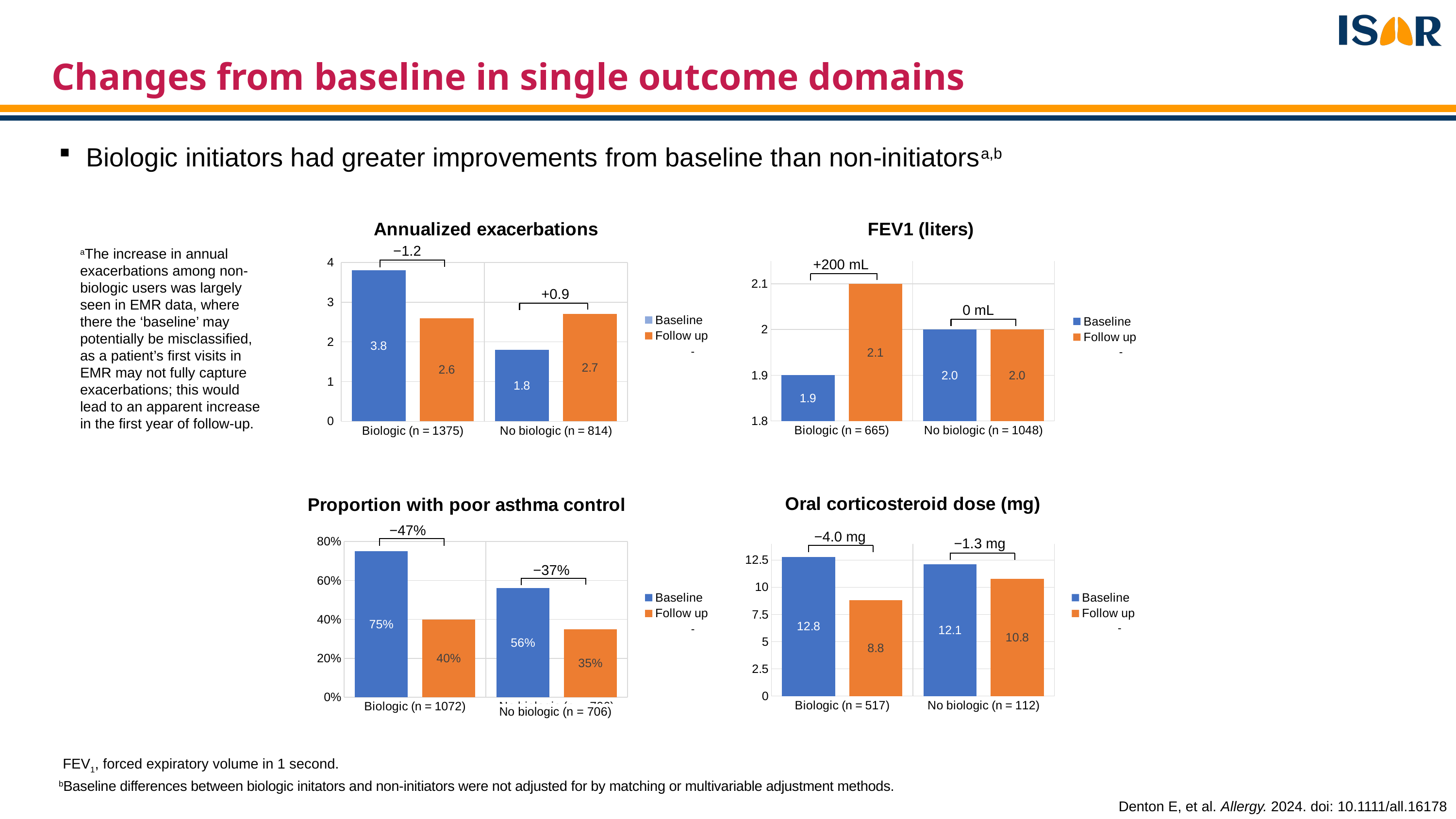
In the Oral corticosteroid dose (mg) chart, what is the Follow up value for Biologic (n = 517)? 8.8 How many series does the legend of the Oral corticosteroid dose (mg) chart list? 2 In the Proportion with poor asthma control chart, which bar is the lowest? Follow up for No biologic (n = 706) In the Annualized exacerbations chart, what is the Baseline value for Biologic (n = 1375)? 3.8 In the Proportion with poor asthma control chart, what is the Baseline value for Biologic (n = 1072)? 75% In the Oral corticosteroid dose (mg) chart, which bar is the highest? Baseline for Biologic (n = 517) In the Proportion with poor asthma control chart, what is the difference between the Baseline and Follow up values for No biologic (n = 706)? 21% In the Annualized exacerbations chart, what is the Follow up value for No biologic (n = 814)? 2.7 In the FEV1 (liters) chart, what is the Follow up value for Biologic (n = 665)? 2.1 In the FEV1 (liters) chart, which is larger for No biologic (n = 1048): the Baseline or the Follow up value, or are they equal? equal What type of chart is the FEV1 (liters) chart? bar chart In the Annualized exacerbations chart, what is the difference between the Baseline and Follow up values for Biologic (n = 1375)? 1.2